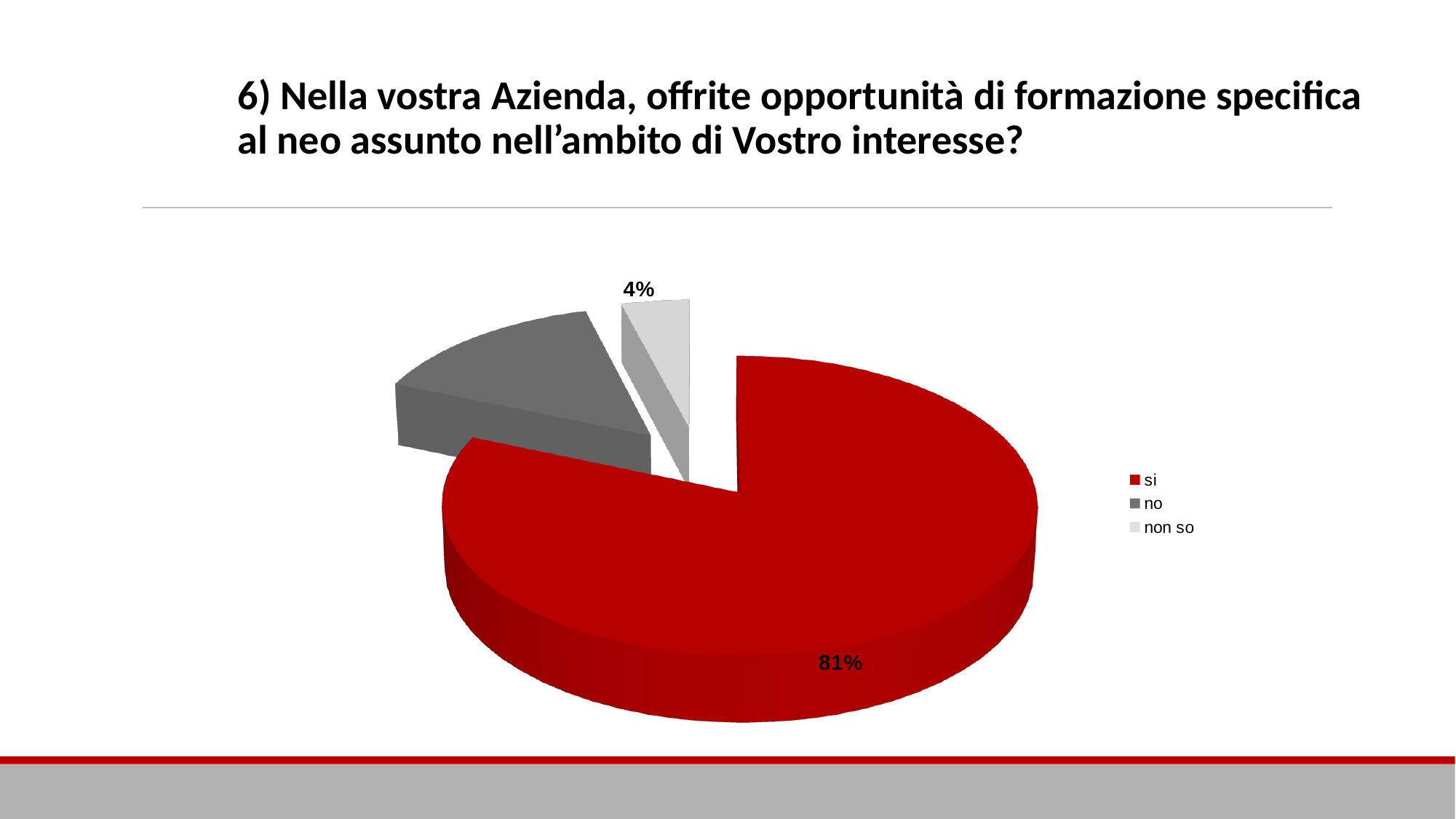
What kind of chart is shown on the slide? Pie chart Which category has the largest slice of the pie chart? si What colour is the "si" slice in the pie chart? Red Which slice is larger, "no" or "non so"? no What percentage of the pie chart is the "si" slice? 81% How many entries does the legend list? 3 What percentage of the pie chart is the "non so" slice? 4% Which slice is larger, "si" or "no"? si Which category has the smallest slice of the pie chart? non so How many slices does the pie chart have? 3 What are the three categories listed in the legend? si, no, non so